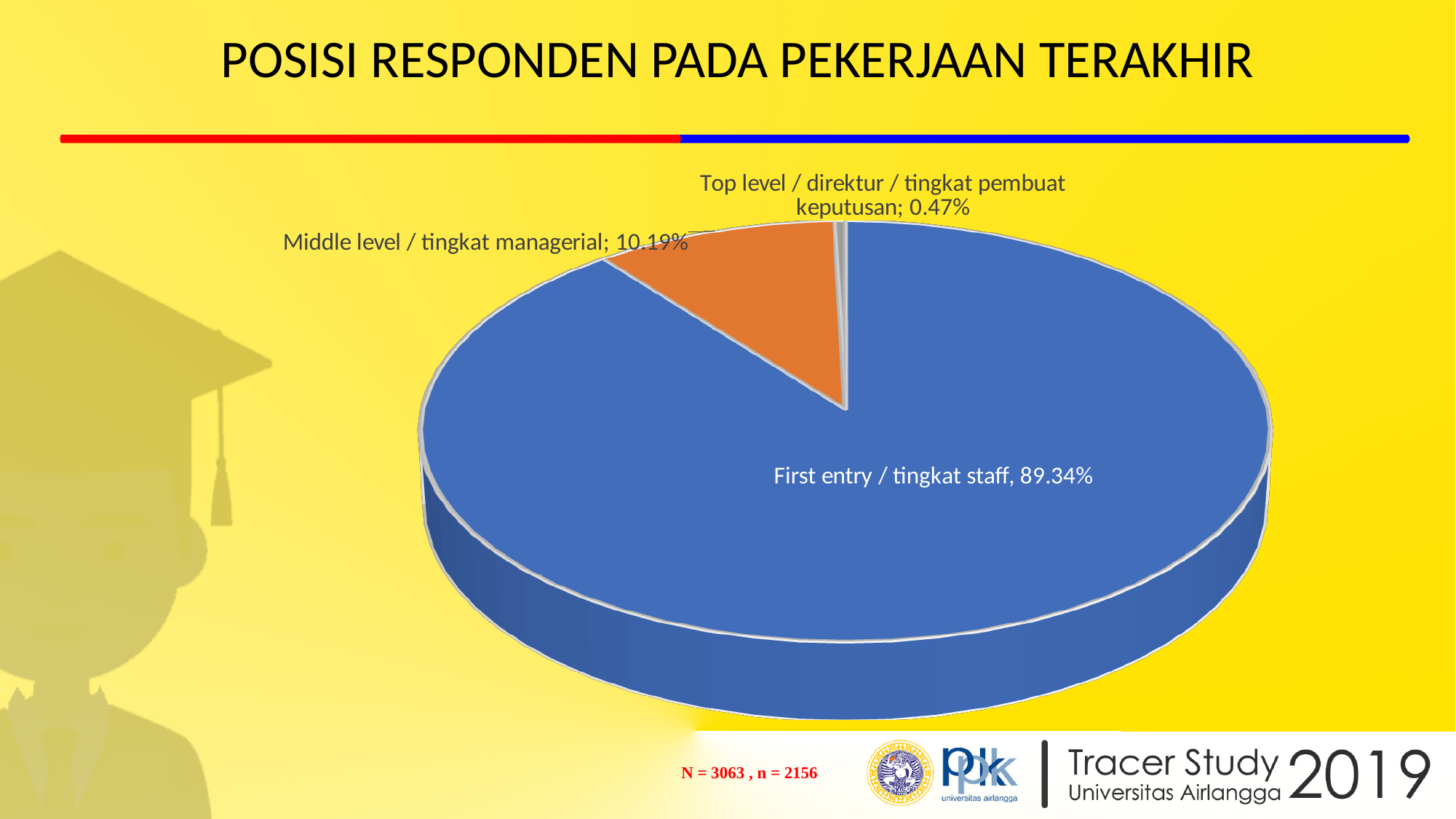
What colour is the slice for Middle level / tingkat managerial? Orange What is the difference in percentage points between the First entry / tingkat staff share and the Middle level / tingkat managerial share? 79.15 Which position category has the smallest share of respondents? Top level / direktur / tingkat pembuat keputusan Which position category has the largest share of respondents? First entry / tingkat staff What is the combined share of the Middle level / tingkat managerial and Top level / direktur / tingkat pembuat keputusan slices? 10.66% What is the title of the slide containing the chart? POSISI RESPONDEN PADA PEKERJAAN TERAKHIR What kind of chart is shown on the slide? Pie chart How many position categories are shown in the pie chart? 3 What share of respondents are at the Middle level / tingkat managerial level? 10.19% Which is larger: the share for Middle level / tingkat managerial or the share for Top level / direktur / tingkat pembuat keputusan? Middle level / tingkat managerial What share of respondents are at the Top level / direktur / tingkat pembuat keputusan level? 0.47% What share of respondents are at the First entry / tingkat staff level? 89.34%